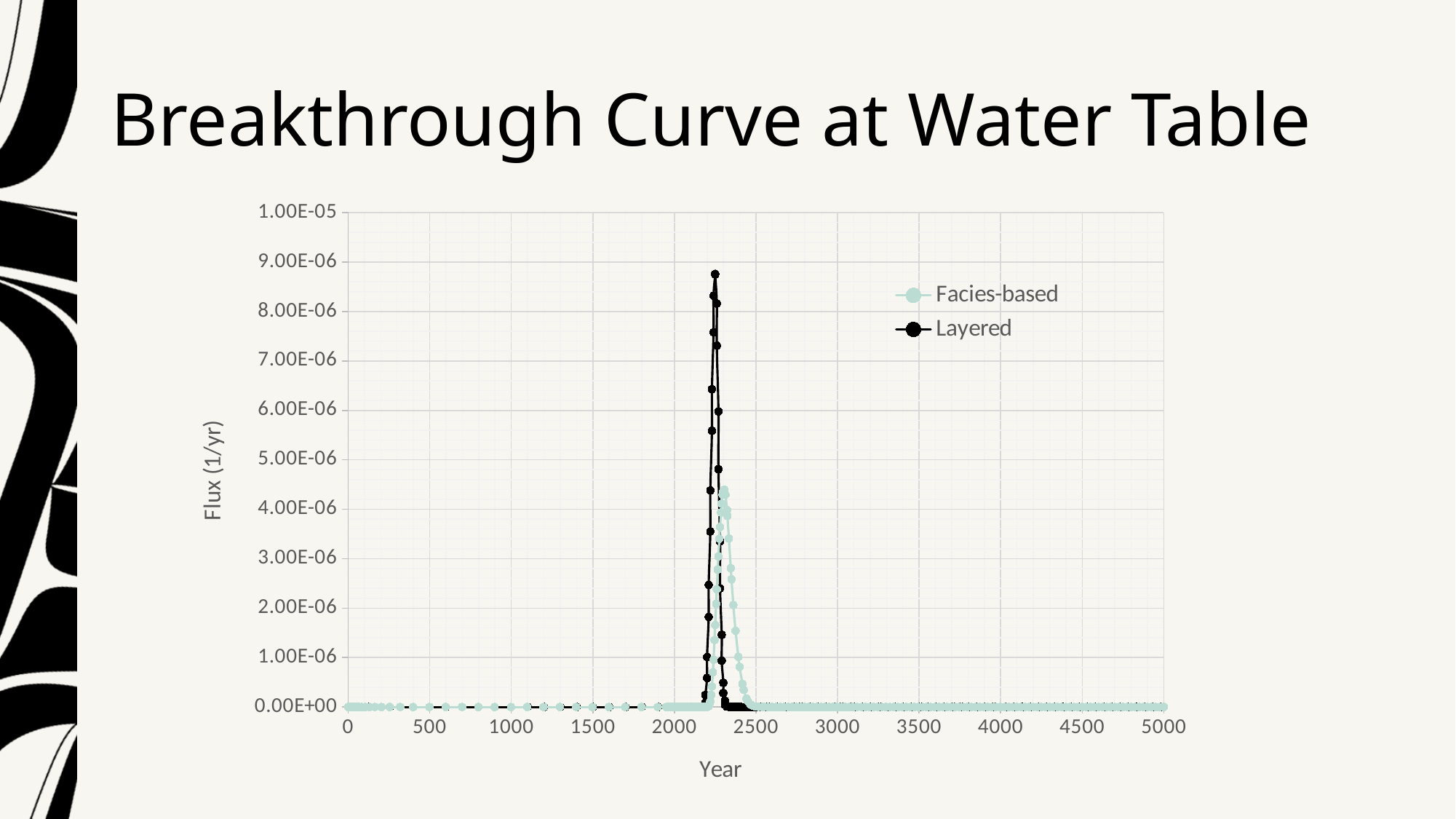
Is the peak value of the Layered series greater or less than 9.00E-06? less What kind of chart is shown on the slide? line chart Is the peak value of the Facies-based series greater or less than 4.00E-06? greater Which series reaches the higher peak flux, Facies-based or Layered? Layered Is the peak value of the Layered series greater or less than 8.00E-06? greater What is the maximum value shown on the x axis? 5000 How many series does the legend list? 2 Which series peaks at a later year, Facies-based or Layered? Facies-based What is the title of the chart? Breakthrough Curve at Water Table What is the label of the y axis? Flux (1/yr)